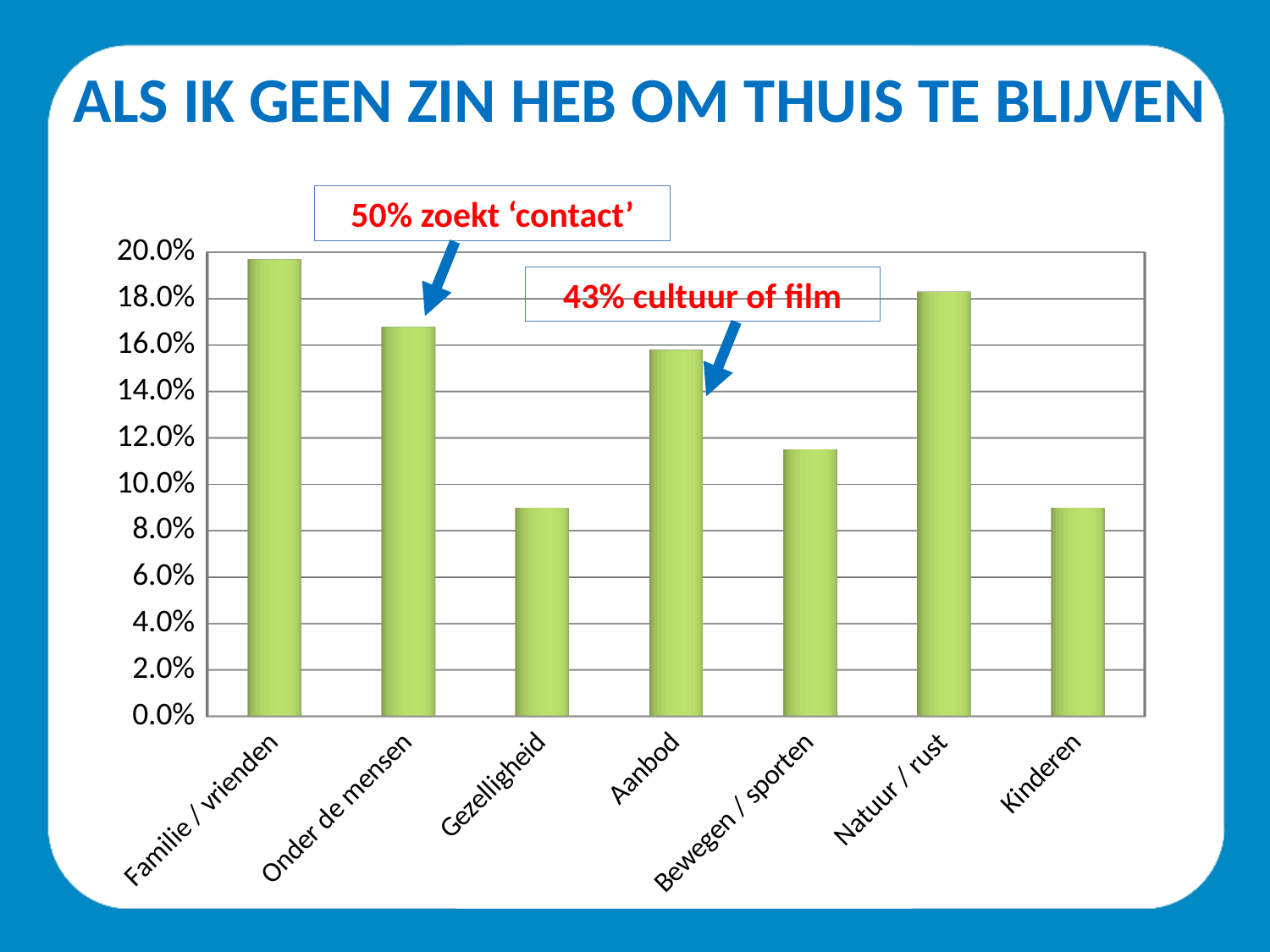
Is the value for Bewegen / sporten greater or less than 10.0%? greater Which is larger, the value for Onder de mensen or the value for Kinderen? Onder de mensen What does the annotation box with the arrow pointing to the Aanbod bar say? 43% cultuur of film How many categories are shown on the x axis of the chart? 7 Which is larger, the value for Natuur / rust or the value for Bewegen / sporten? Natuur / rust Is the value for Familie / vrienden greater or less than 18.0%? greater Which category has the highest value in the chart? Familie / vrienden Is the value for Gezelligheid greater or less than 10.0%? less What kind of chart is shown on the slide? bar chart